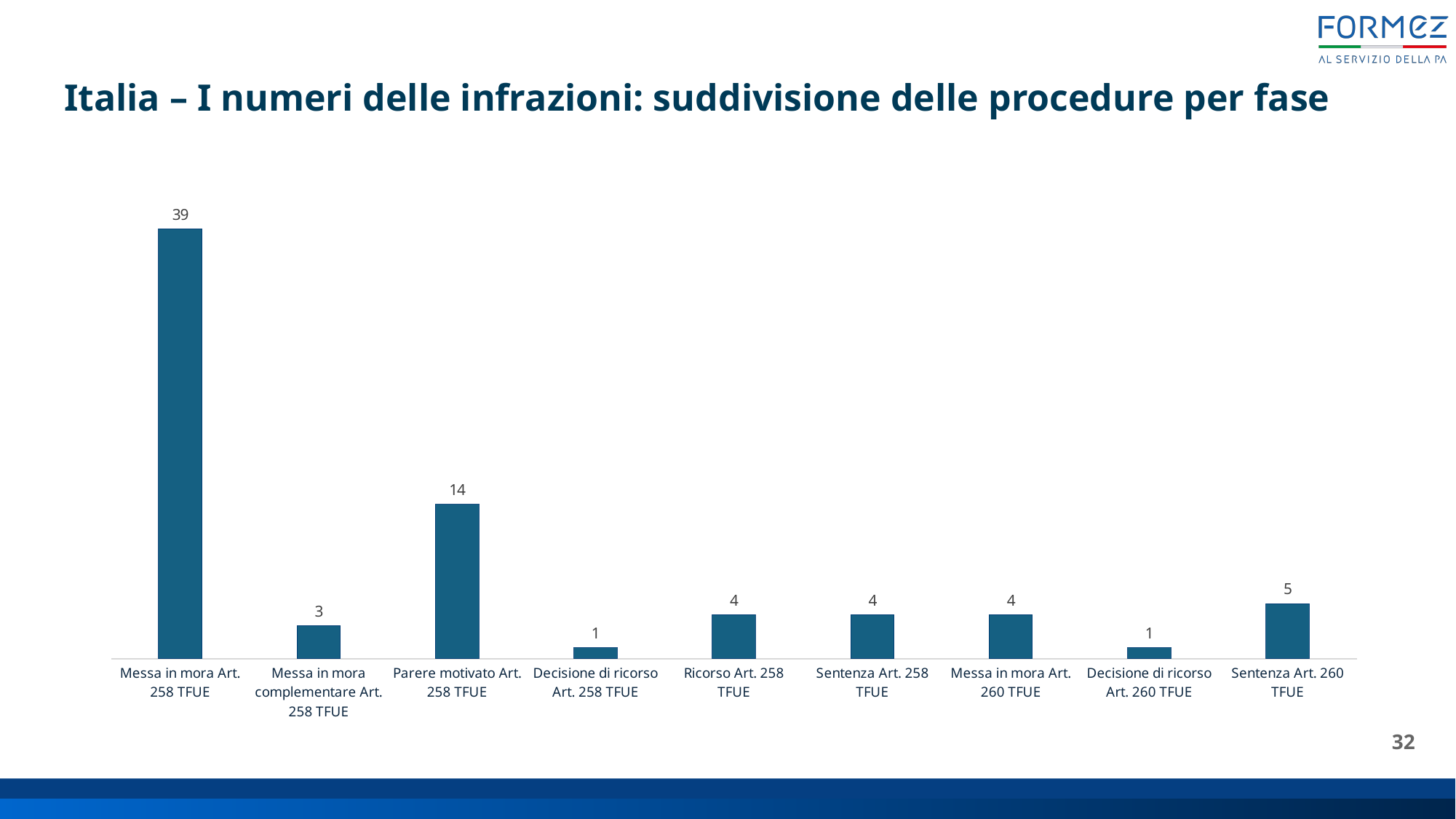
What is the title of the slide containing the chart? Italia – I numeri delle infrazioni: suddivisione delle procedure per fase Which category has the highest value? Messa in mora Art. 258 TFUE What is the value for Decisione di ricorso Art. 260 TFUE? 1 What is the value for Parere motivato Art. 258 TFUE? 14 What is the value for Messa in mora complementare Art. 258 TFUE? 3 What is the difference between the values for Messa in mora Art. 258 TFUE and Parere motivato Art. 258 TFUE? 25 What is the value for Messa in mora Art. 258 TFUE? 39 Which is larger, the value for Sentenza Art. 260 TFUE or the value for Ricorso Art. 258 TFUE? Sentenza Art. 260 TFUE Which two categories share the lowest value? Decisione di ricorso Art. 258 TFUE and Decisione di ricorso Art. 260 TFUE How many categories are shown on the x axis? 9 What kind of chart is shown on the slide? Bar chart What is the value for Sentenza Art. 260 TFUE? 5